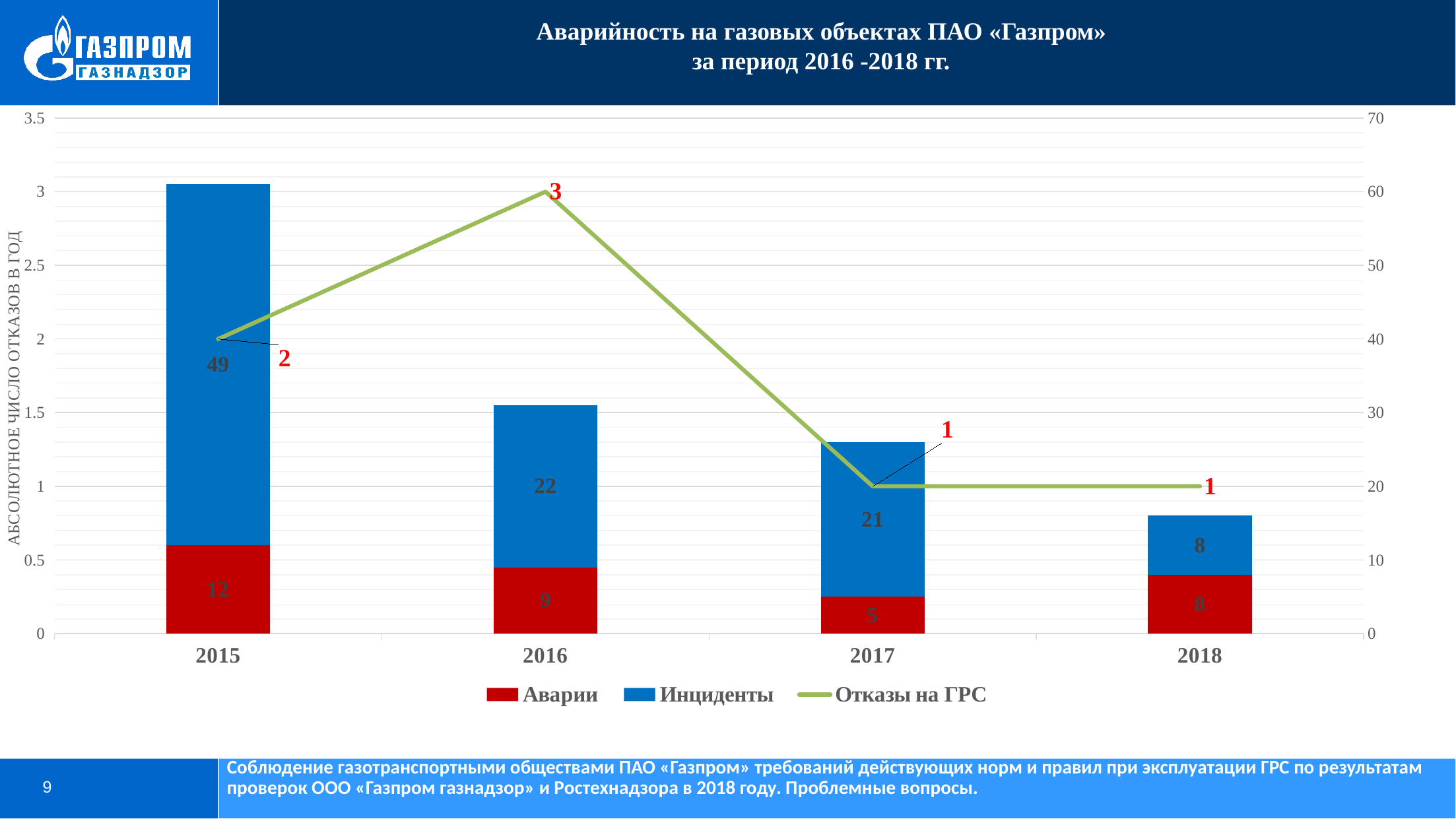
What is the difference between Инциденты in 2015 and Инциденты in 2016? 27 Which year has the lowest value of Аварии? 2017 What is the value of Аварии for 2015? 12 Do the Инциденты values rise or fall from 2015 to 2018? fall What is the value of Инциденты for 2018? 8 Which is larger: Аварии in 2016 or Аварии in 2018? Аварии in 2016 Which year has the highest value of Инциденты? 2015 How many years are shown on the x axis? 4 How many series does the legend list? 3 What is the value of Отказы на ГРС for 2016? 3 What is the total of the stacked bar for 2017 (Аварии plus Инциденты)? 26 What is the value of Инциденты for 2016? 22